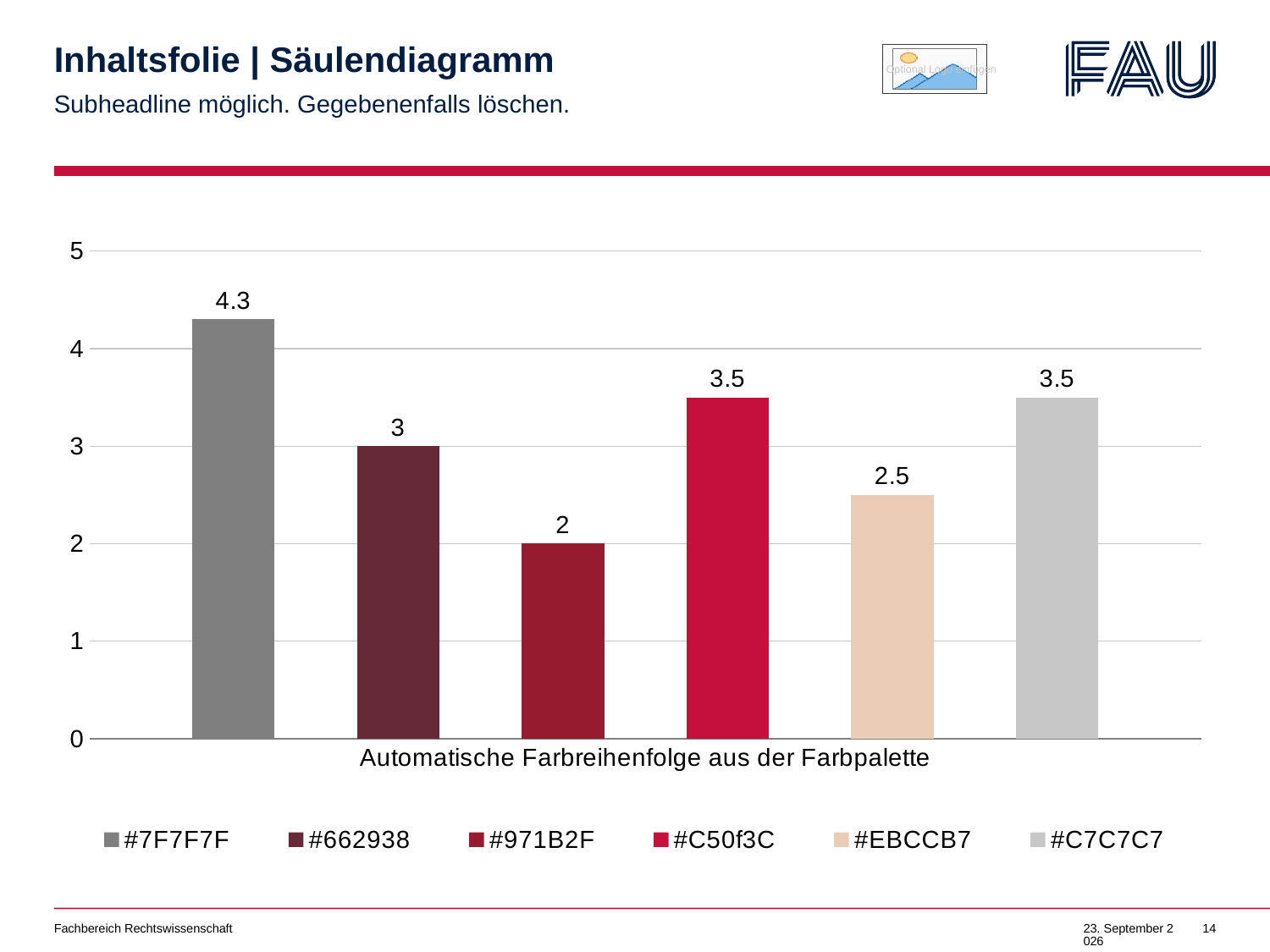
Which series has the lowest value? #971B2F Is the value for #7F7F7F greater or less than 4? greater Which is larger, the value for #662938 or the value for #C7C7C7? #C7C7C7 What is the category label shown on the x axis? Automatische Farbreihenfolge aus der Farbpalette What is the value for the series #971B2F? 2 What is the value for the series #EBCCB7? 2.5 Which series has the highest value? #7F7F7F What kind of chart is shown on the slide? bar chart What is the value for the series #7F7F7F? 4.3 What is the difference between the values for #7F7F7F and #662938? 1.3 How many series does the legend list? 6 What is the difference between the values for #C50f3C and #EBCCB7? 1